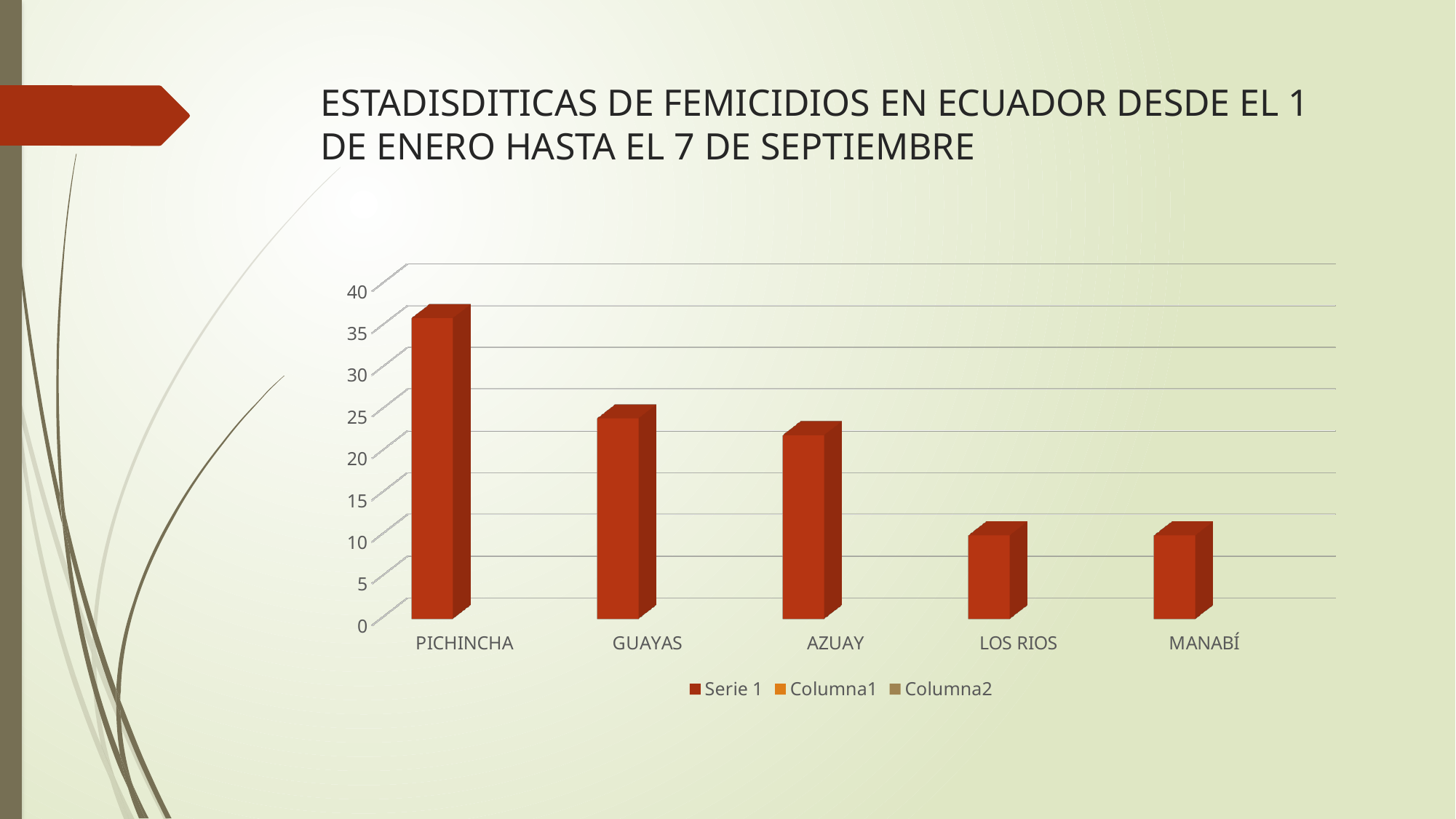
Is the value for AZUAY greater or less than 30? less Do the bar values generally rise or fall from left to right across the x axis? fall Is the value for LOS RIOS greater or less than 15? less How many provinces (categories) are shown on the x axis of the chart? 5 How many series does the chart's legend list? 3 Is the value for GUAYAS greater or less than 20? greater Which is larger, the value for PICHINCHA or the value for GUAYAS? PICHINCHA What is the name of the first series listed in the chart's legend? Serie 1 Which province has the highest bar in the chart? PICHINCHA What kind of chart is shown on the slide? Bar chart